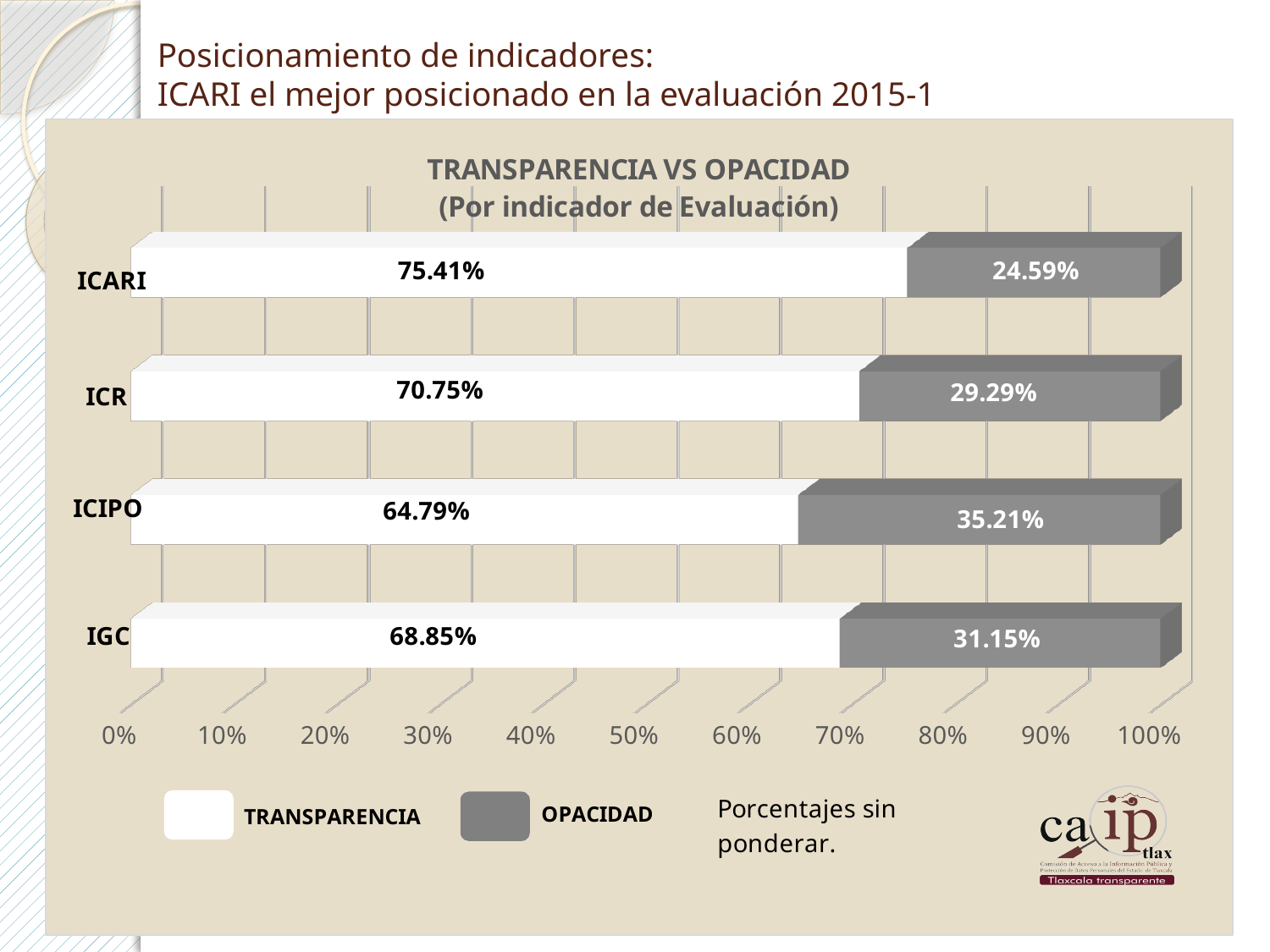
Which indicator has the highest TRANSPARENCIA value? ICARI What kind of chart is shown on the slide? Stacked bar chart Which is larger, the OPACIDAD value for IGC or the OPACIDAD value for ICR? IGC Which indicator has the highest OPACIDAD value? ICIPO What is the OPACIDAD value for ICIPO? 35.21% Which indicator has the lowest TRANSPARENCIA value? ICIPO What is the OPACIDAD value for ICR? 29.29% What is the TRANSPARENCIA value for IGC? 68.85% How many indicators are shown on the chart? 4 What is the TRANSPARENCIA value for ICARI? 75.41% How many series does the legend list? 2 What is the difference between the TRANSPARENCIA values of ICARI and ICR? 4.66%